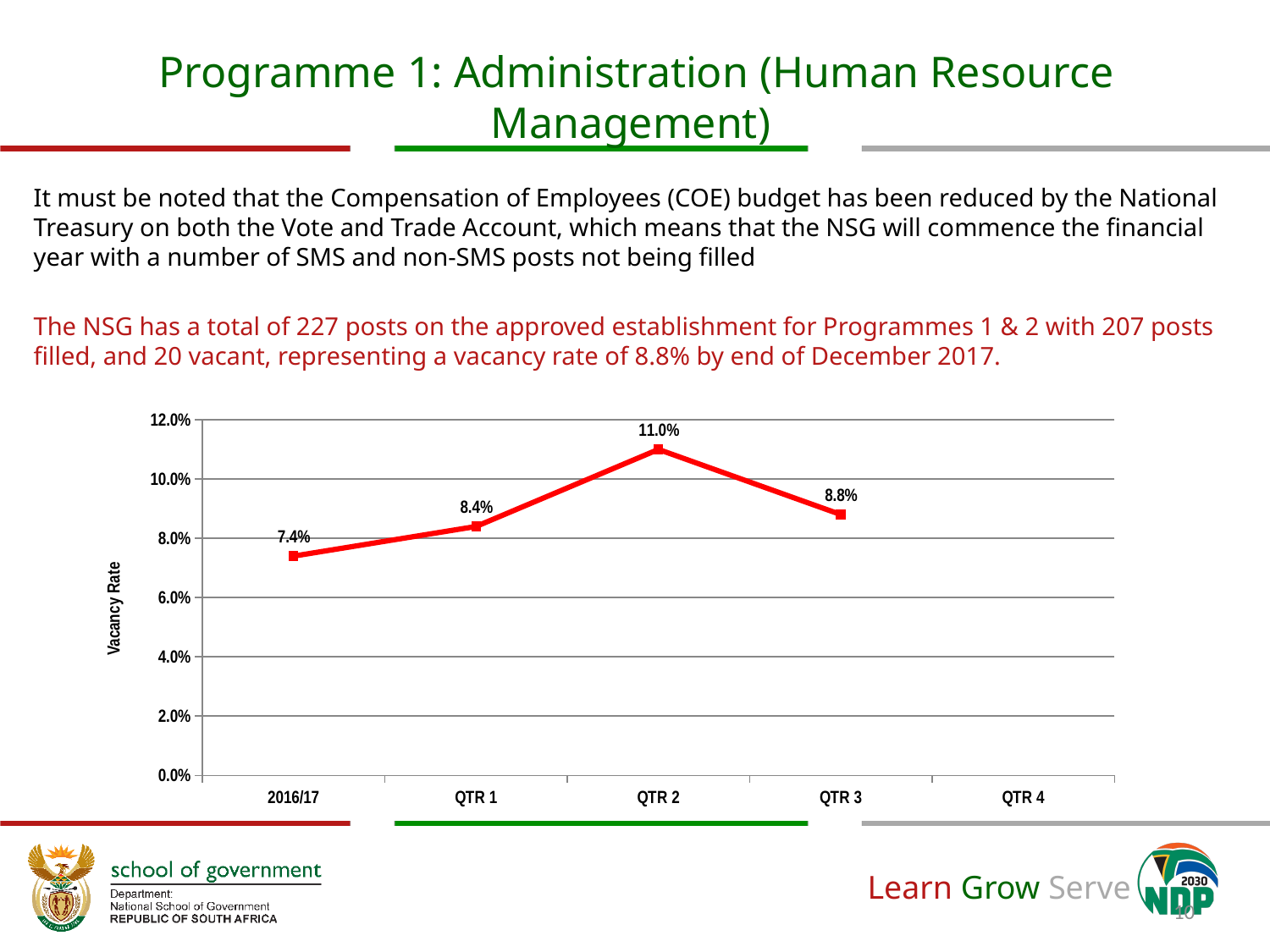
Which period has the highest vacancy rate? QTR 2 Which is larger, the vacancy rate for QTR 1 or QTR 3? QTR 3 Is the vacancy rate for QTR 2 greater or less than 10.0%? greater What is the label of the y axis? Vacancy Rate How many periods are labelled on the x axis? 5 What is the vacancy rate for QTR 1? 8.4% What is the vacancy rate for QTR 2? 11.0% What kind of chart is shown on the slide? line chart What is the vacancy rate for QTR 3? 8.8% What is the difference between the vacancy rate in QTR 2 and QTR 3? 2.2% What is the vacancy rate for 2016/17? 7.4% Which period has the lowest plotted vacancy rate? 2016/17